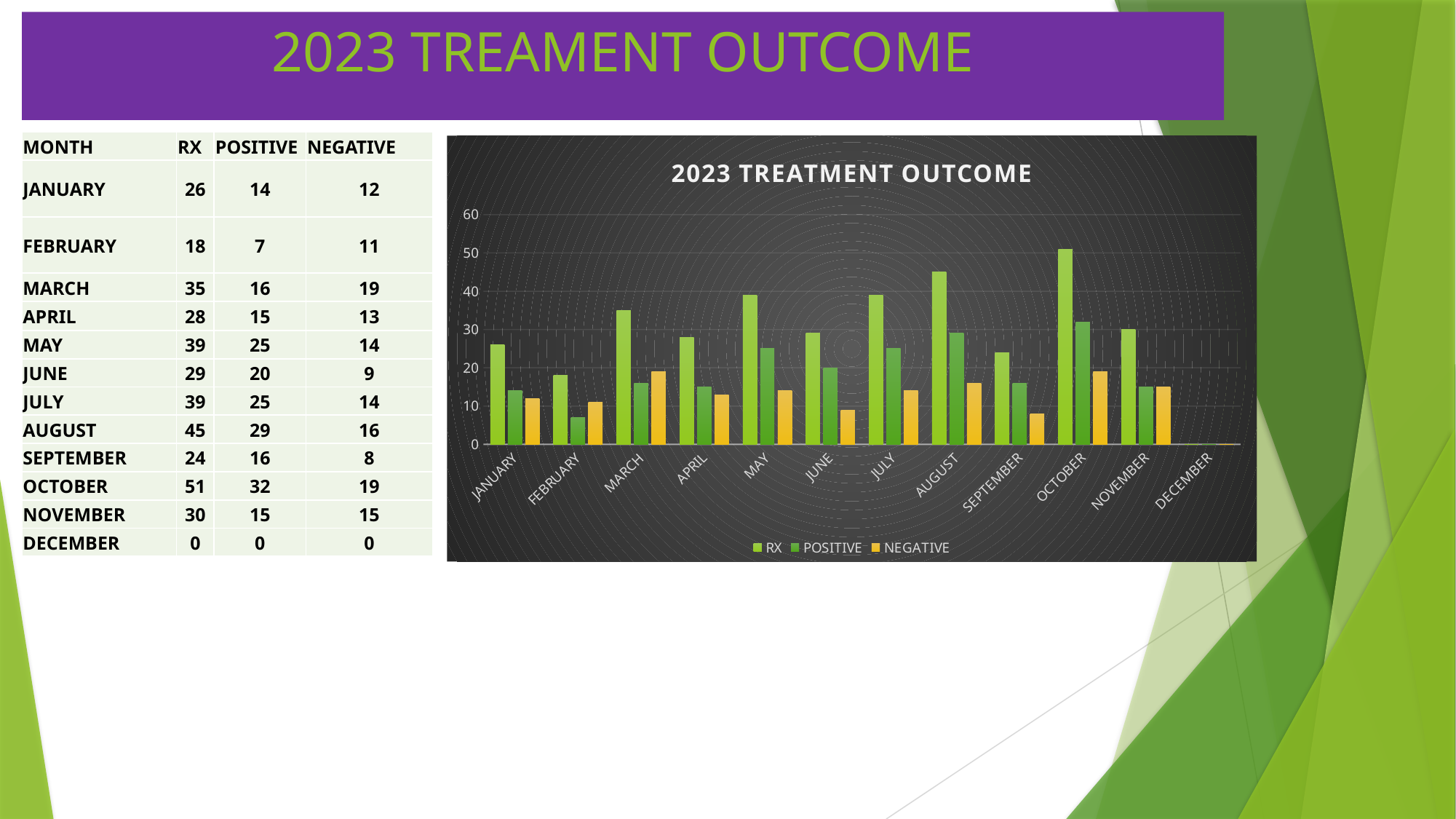
What is the title of the chart? 2023 TREATMENT OUTCOME What type of chart is shown on the slide? bar chart What is the RX value for OCTOBER? 51 What is the NEGATIVE value for JUNE? 9 What is the POSITIVE value for AUGUST? 29 Which month has the lowest RX value? DECEMBER How many months are shown on the x axis of the chart? 12 What is the difference between the RX value for OCTOBER and the RX value for SEPTEMBER? 27 Which is larger, the POSITIVE value for MARCH or the NEGATIVE value for MARCH? NEGATIVE Is the RX value for MAY greater or less than 30? greater How many series does the chart legend list? 3 Which month has the highest RX value? OCTOBER